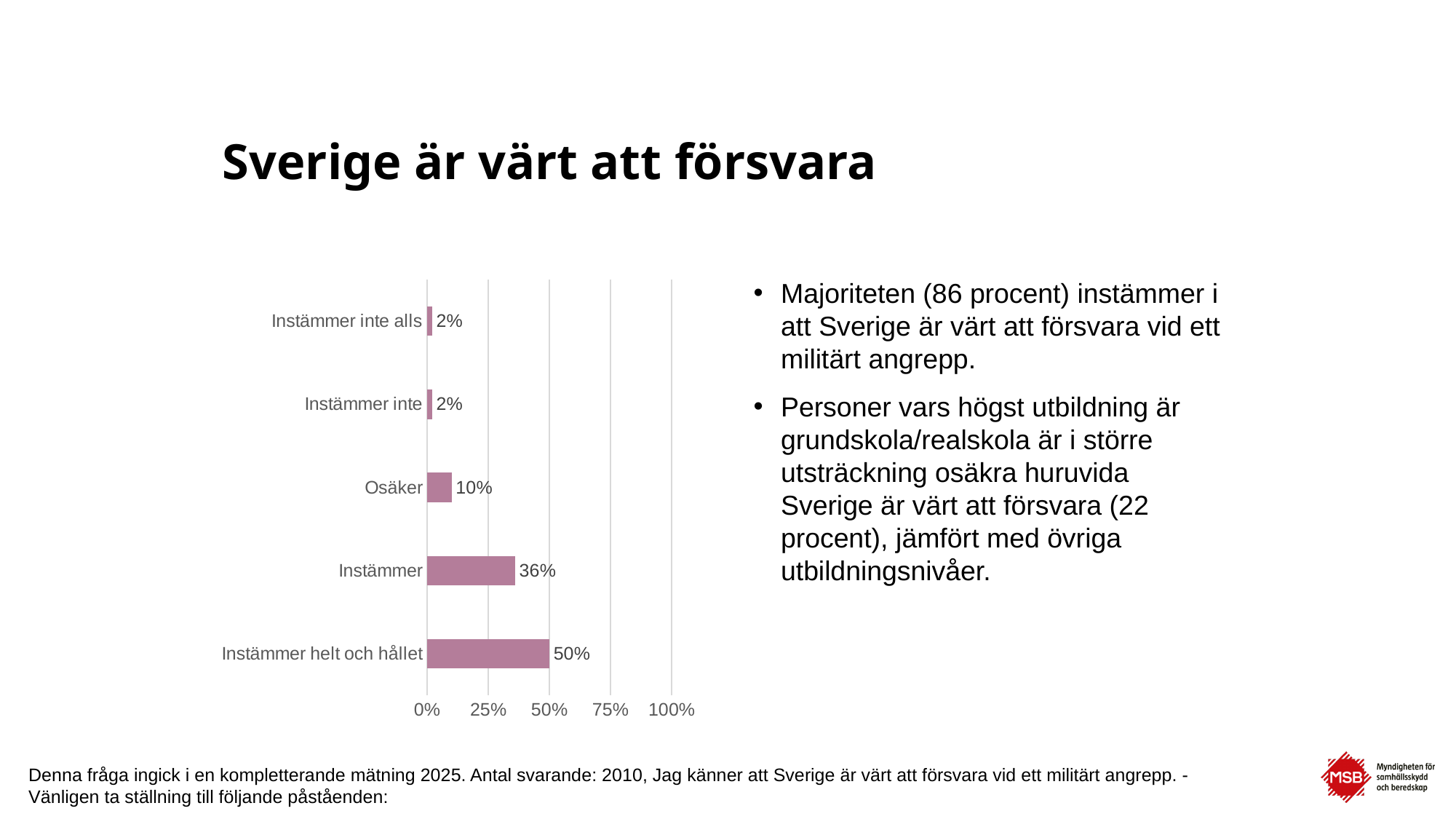
What is the value for "Osäker"? 10% What kind of chart is shown on the slide? Bar chart What is the difference between the values for "Instämmer helt och hållet" and "Instämmer"? 14% How many categories are shown in the chart? 5 What is the title of the slide containing the chart? Sverige är värt att försvara What is the value for "Instämmer helt och hållet"? 50% What is the value for "Instämmer"? 36% What is the combined value of "Instämmer helt och hållet" and "Instämmer"? 86% Which category has the highest value? Instämmer helt och hållet Is the value for "Instämmer" greater or less than 25%? greater What is the value for "Instämmer inte alls"? 2% Which is larger, the value for "Osäker" or the value for "Instämmer"? Instämmer